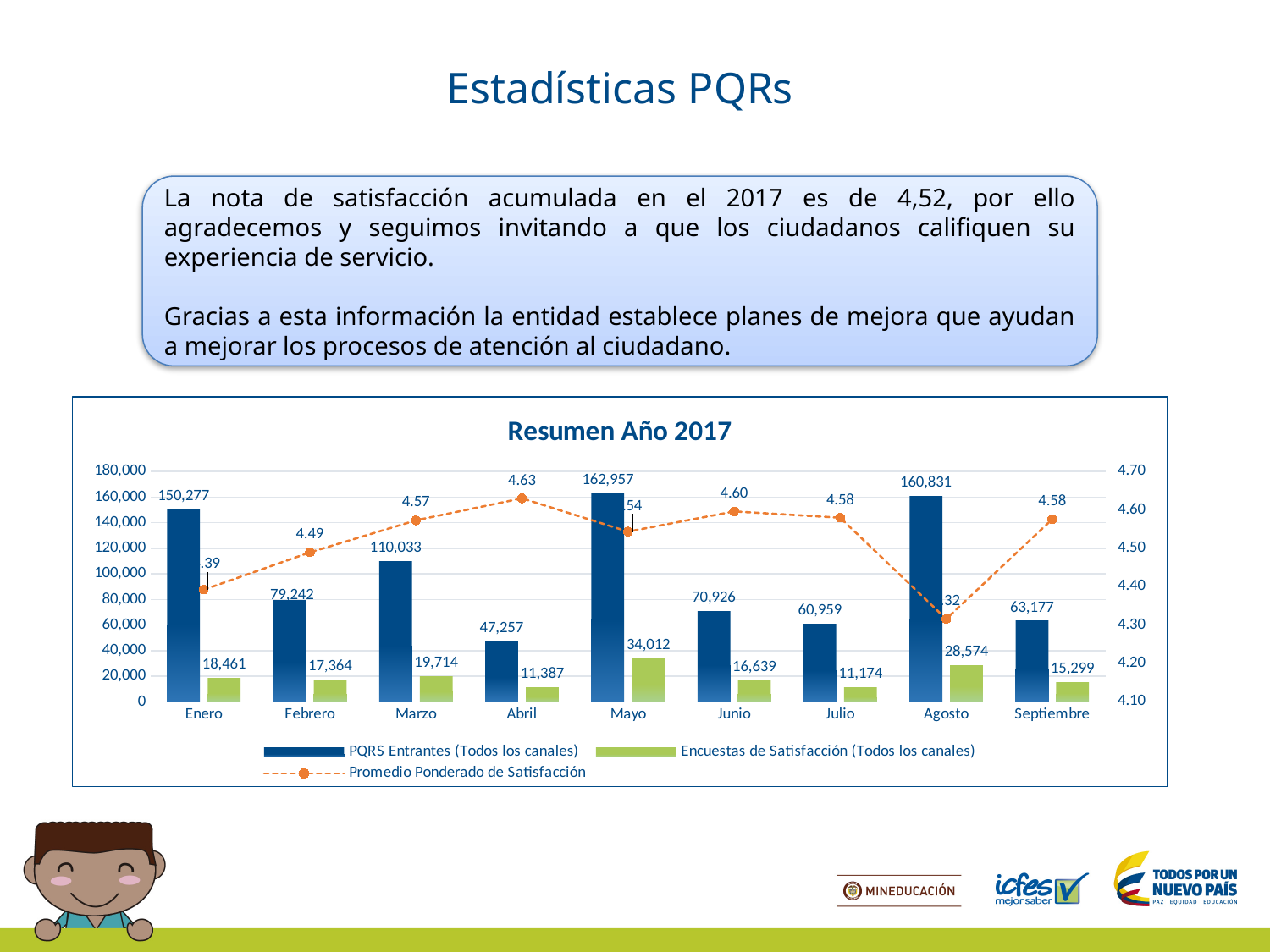
In the chart 'Resumen Año 2017', what is the Promedio Ponderado de Satisfacción for Abril? 4.63 In the chart 'Resumen Año 2017', which month has the highest value of PQRS Entrantes (Todos los canales)? Mayo What kind of chart is 'Resumen Año 2017'? A bar chart combined with a line In the chart 'Resumen Año 2017', which month has the highest Promedio Ponderado de Satisfacción? Abril In the chart 'Resumen Año 2017', what is the value of PQRS Entrantes (Todos los canales) for Mayo? 162,957 How many months are shown on the x axis of the chart 'Resumen Año 2017'? 9 In the chart 'Resumen Año 2017', which month has more Encuestas de Satisfacción, Marzo or Febrero? Marzo How many series does the legend of the chart 'Resumen Año 2017' list? 3 In the chart 'Resumen Año 2017', what is the difference between the PQRS Entrantes values for Mayo and Agosto? 2,126 In the chart 'Resumen Año 2017', what is the value of Encuestas de Satisfacción (Todos los canales) for Agosto? 28,574 In the chart 'Resumen Año 2017', is the value of PQRS Entrantes for Abril greater or less than 60,000? less In the chart 'Resumen Año 2017', which month has the lowest value of Encuestas de Satisfacción (Todos los canales)? Julio